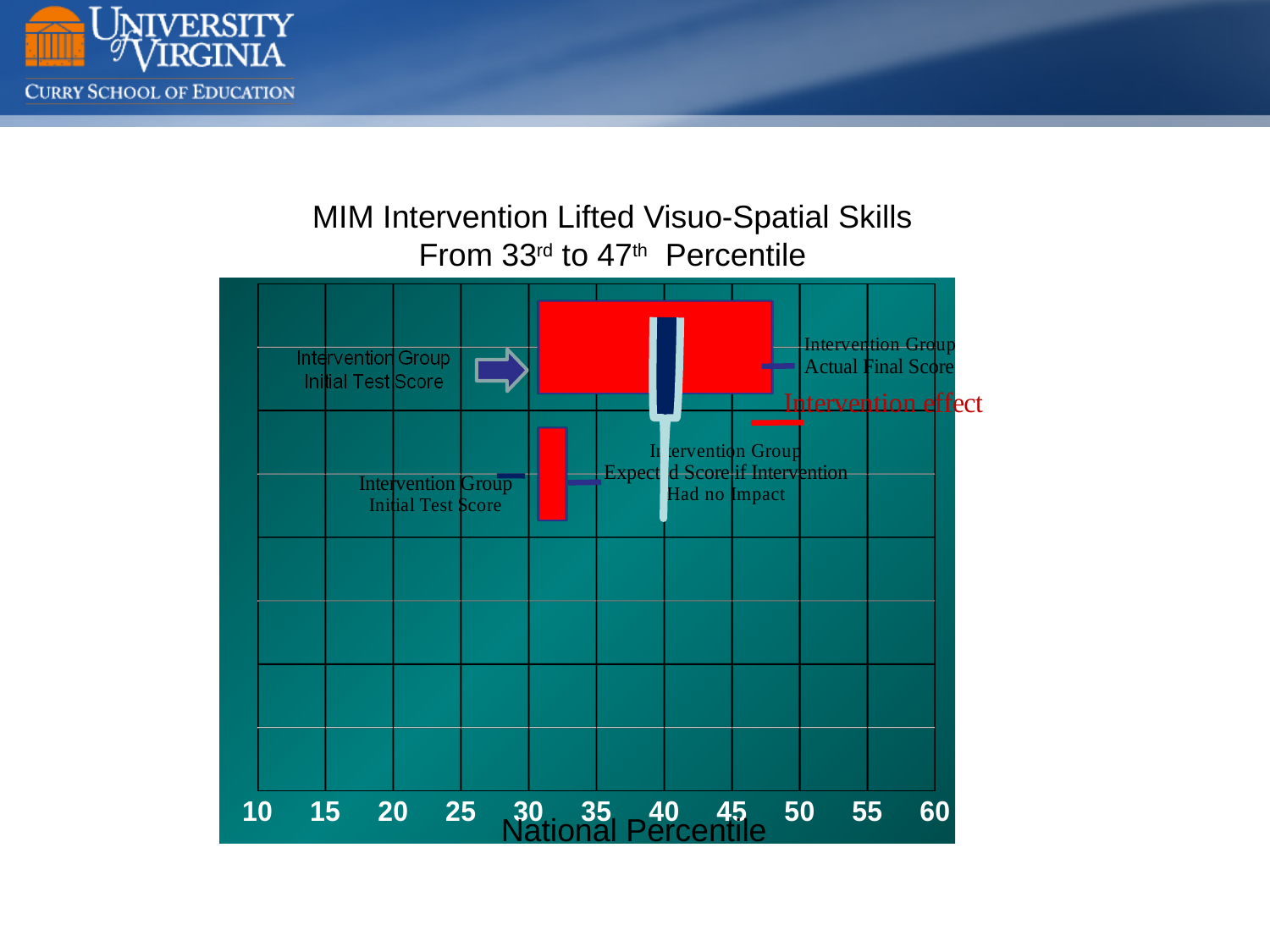
Is the Intervention Group Actual Final Score greater or less than 40 on the National Percentile axis? greater Is the Intervention Group Actual Final Score greater or less than 50 on the National Percentile axis? less What is the highest value shown on the National Percentile axis? 60 Is the Intervention Group Initial Test Score greater or less than 35 on the National Percentile axis? less According to the chart title, what percentile was the intervention group's initial visuo-spatial score? 33rd By how many percentile points did the intervention lift visuo-spatial skills, according to the title? 14 What is the title of the chart on the slide? MIM Intervention Lifted Visuo-Spatial Skills From 33rd to 47th Percentile What is the label of the x axis of the chart? National Percentile Which is larger, the Intervention Group Actual Final Score or the Intervention Group Initial Test Score? Intervention Group Actual Final Score According to the chart title, what percentile did the intervention group reach after the intervention? 47th What kind of chart is shown on the slide? bar chart